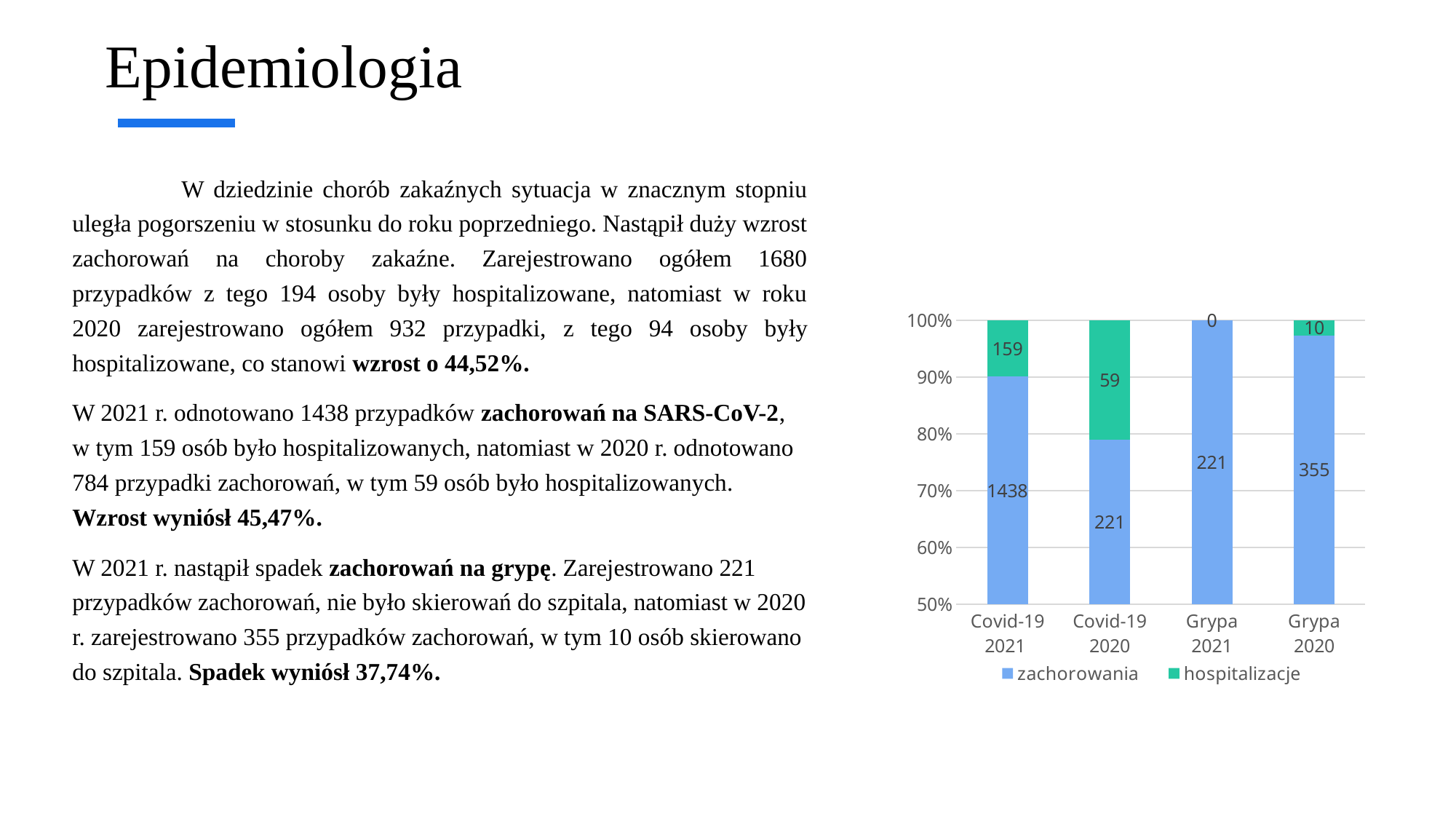
What is the total of the stacked bar for Covid-19 2021? 1597 What is the value of hospitalizacje for Grypa 2021? 0 How many series does the legend list? 2 What is the value of zachorowania for Grypa 2020? 355 Which is larger: zachorowania for Grypa 2020 or zachorowania for Grypa 2021? Grypa 2020 Which category has the highest value of zachorowania? Covid-19 2021 How many categories are shown on the x axis? 4 What is the value of zachorowania for Covid-19 2021? 1438 Which category has the lowest value of hospitalizacje? Grypa 2021 What is the difference between hospitalizacje for Covid-19 2021 and Covid-19 2020? 100 What kind of chart is shown on the slide? Stacked bar chart What is the value of hospitalizacje for Covid-19 2020? 59